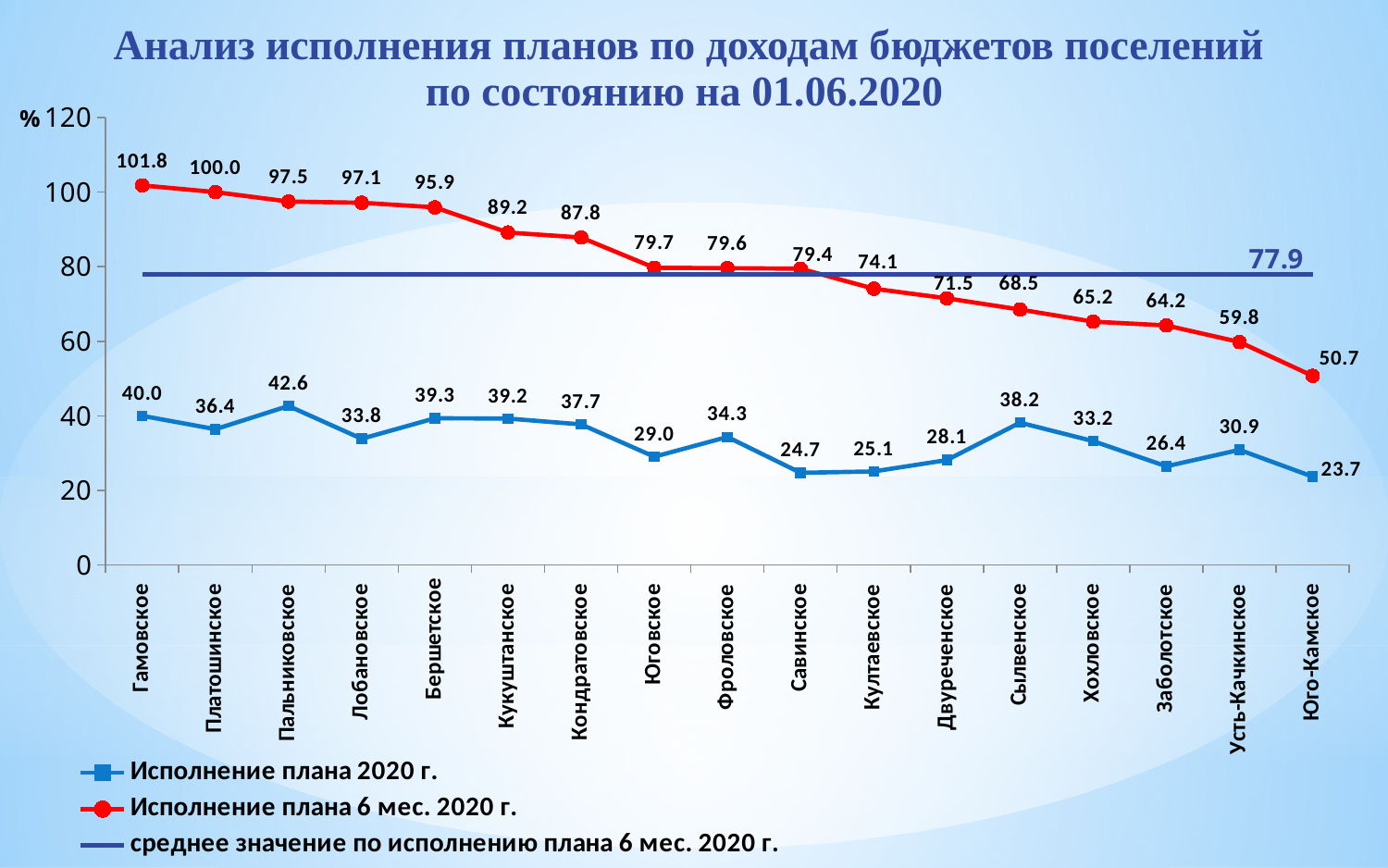
What kind of chart is shown on the slide? line chart What is the value of 'Исполнение плана 6 мес. 2020 г.' for Кукуштанское? 89.2 Which settlement has the highest value for 'Исполнение плана 2020 г.'? Пальниковское What value is shown for the average line 'среднее значение по исполнению плана 6 мес. 2020 г.'? 77.9 Which is larger for Фроловское: 'Исполнение плана 2020 г.' or 'Исполнение плана 6 мес. 2020 г.'? Исполнение плана 6 мес. 2020 г. Which settlement has the highest value for 'Исполнение плана 6 мес. 2020 г.'? Гамовское What is the value of 'Исполнение плана 2020 г.' for Сылвенское? 38.2 Do the values of 'Исполнение плана 6 мес. 2020 г.' rise or fall from left to right along the x axis? fall What is the difference between the 'Исполнение плана 6 мес. 2020 г.' values for Гамовское and Юго-Камское? 51.1 How many settlements (categories) are plotted along the x axis? 17 Which settlement has the lowest value for 'Исполнение плана 2020 г.'? Юго-Камское How many series does the legend list? 3